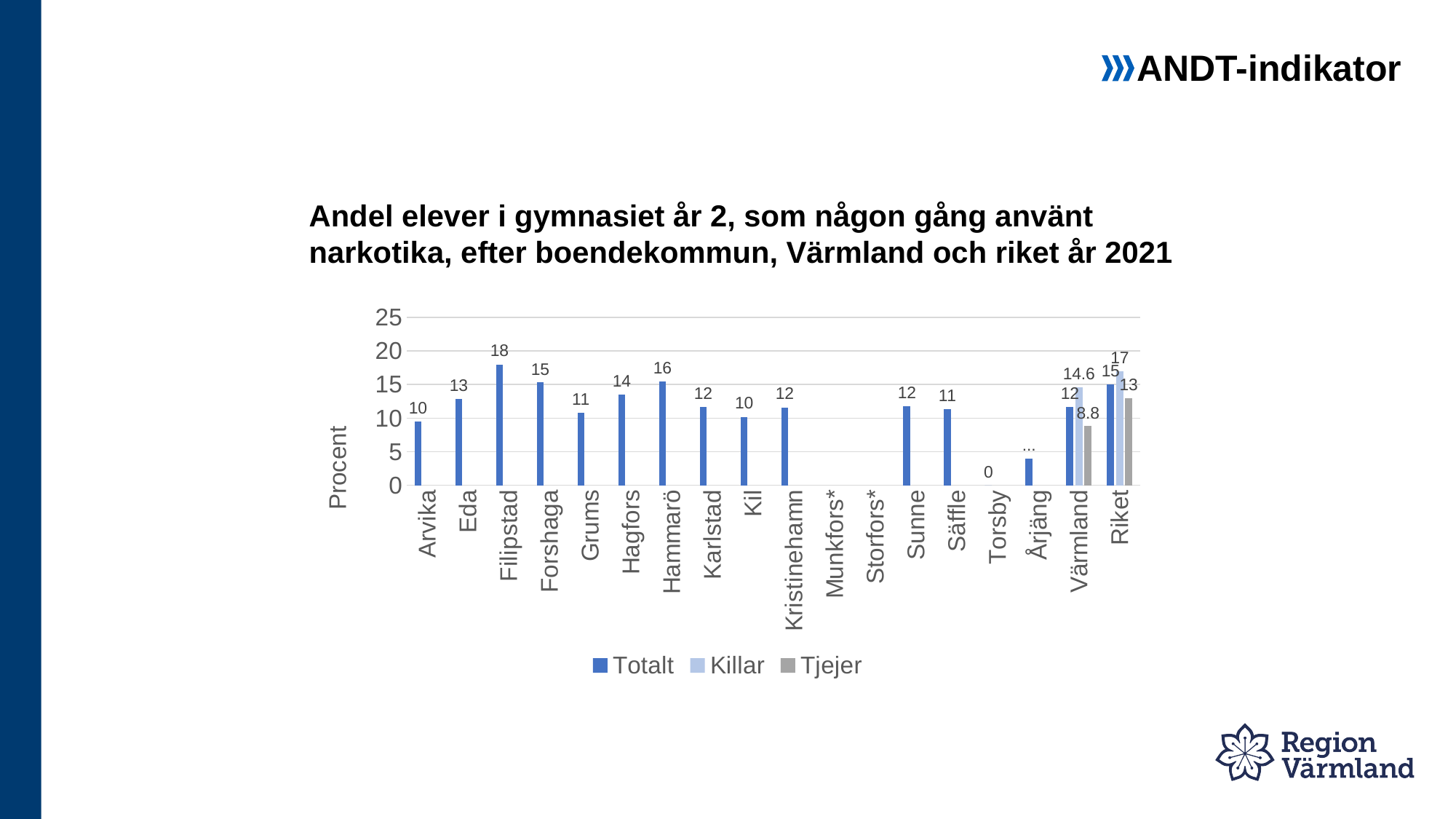
What is the label on the y axis? Procent Which municipality has the highest Totalt value? Filipstad How many series does the legend list? 3 What is the Killar value for Riket? 17 Which has a higher Totalt value, Hammarö or Forshaga? Hammarö What is the Tjejer value for Värmland? 8.8 What kind of chart is shown on the slide? Bar chart What is the Totalt value for Filipstad? 18 What is the Totalt value shown for Torsby? 0 What is the difference between the Killar and Tjejer values for Riket? 4 What is the difference between the Totalt values for Filipstad and Arvika? 8 How many categories are shown on the x axis? 18